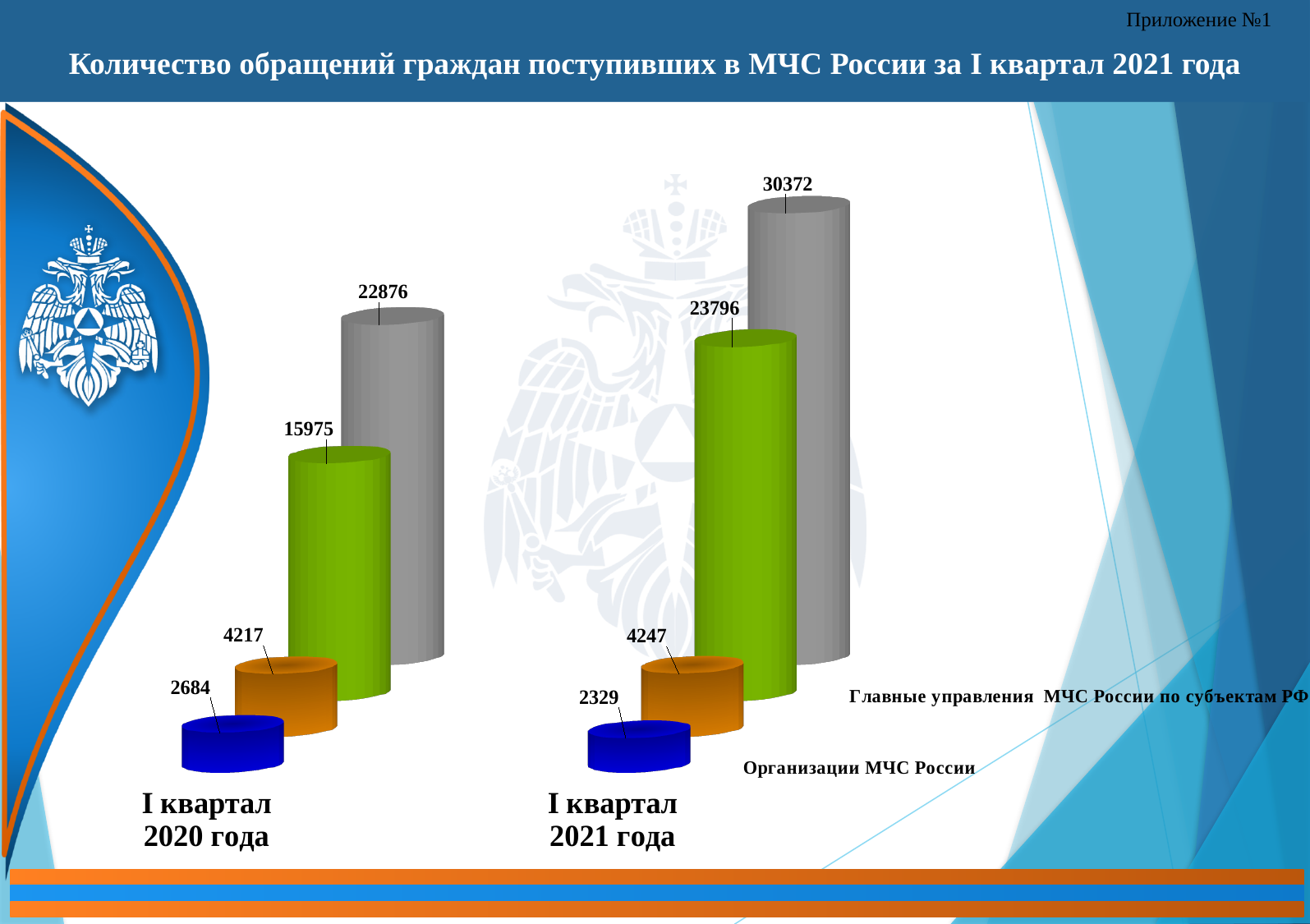
What is the value of the orange bar for I квартал 2020 года? 4217 What kind of chart is shown on the slide? Bar chart What is the title of the chart? Количество обращений граждан поступивших в МЧС России за I квартал 2021 года What is the value of the green bar for I квартал 2020 года? 15975 By how much did the gray bar value increase from I квартал 2020 года to I квартал 2021 года? 7496 What is the value of the gray bar for I квартал 2021 года? 30372 What is the difference between the green bar values for I квартал 2021 года and I квартал 2020 года? 7821 How many quarter categories are shown on the chart? 2 Which bar has the lowest value on the chart? The blue bar for I квартал 2021 года (2329) Which bar has the highest value on the chart? The gray bar for I квартал 2021 года (30372) Is the blue bar value larger for I квартал 2020 года or I квартал 2021 года? I квартал 2020 года What is the value of the blue bar for I квартал 2021 года? 2329